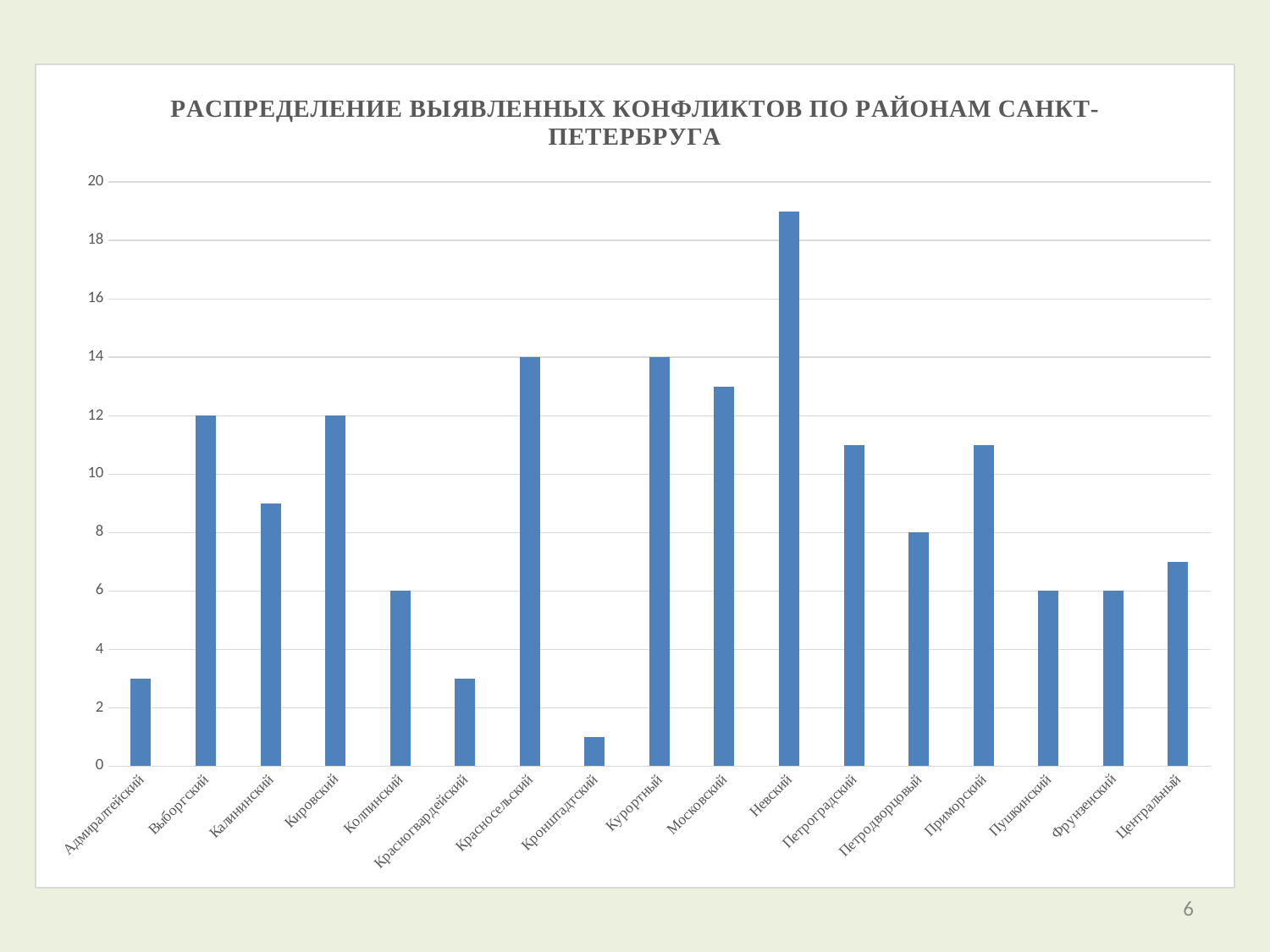
What is the value for Петродворцовый? 8 What kind of chart is shown on the slide? Bar chart Is the value for Невский greater or less than 18? greater Which district has the highest number of identified conflicts? Невский What is the value for Красносельский? 14 Is the value for Адмиралтейский greater or less than 4? less Which has a larger value, Московский or Петроградский? Московский What is the value for Выборгский? 12 What is the value for Колпинский? 6 Which district has the lowest number of identified conflicts? Кронштадтский What is the difference between the values for Красносельский and Колпинский? 8 How many districts are shown on the x axis? 17